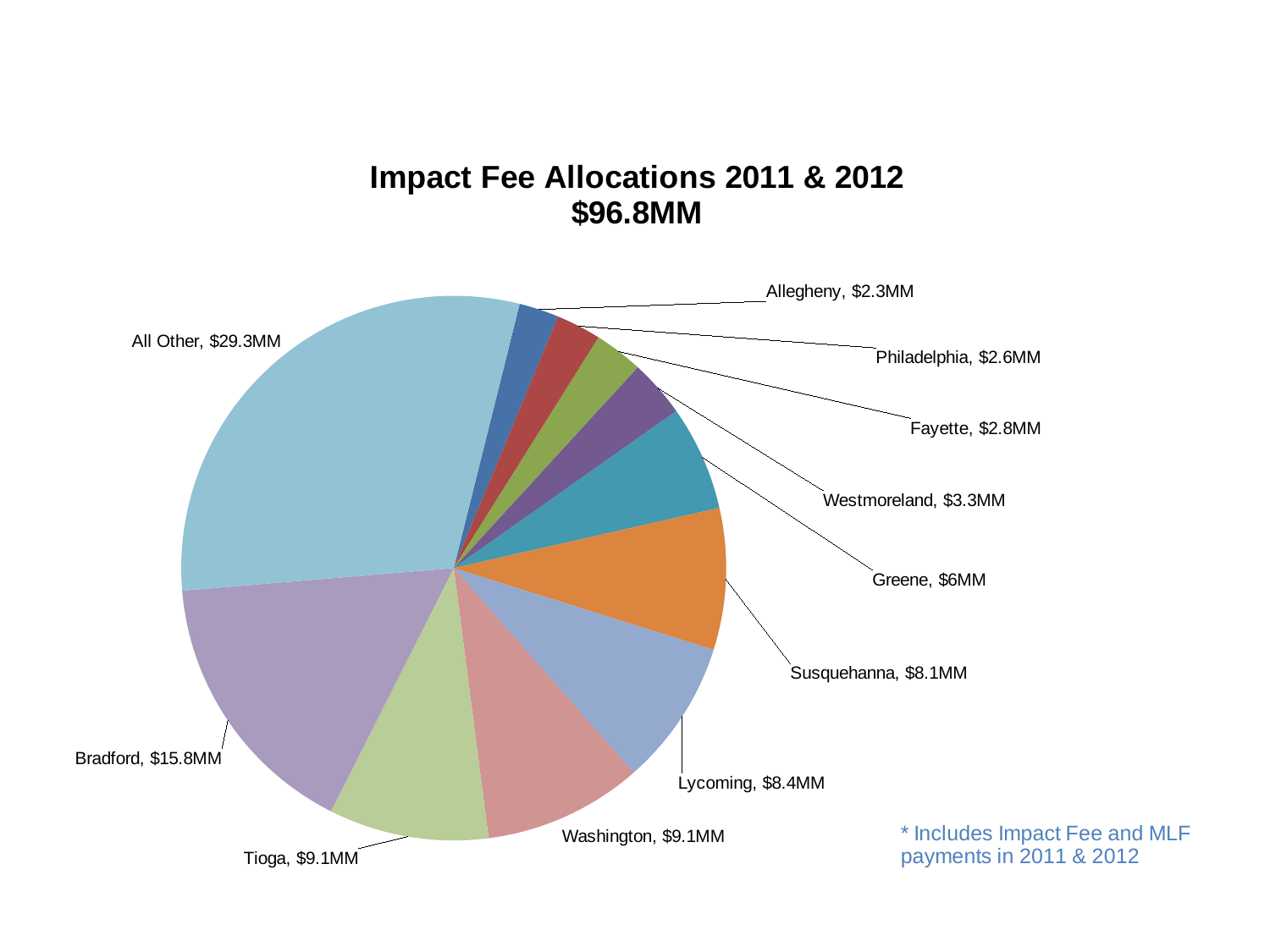
What is the difference between the values for Bradford and Tioga? $6.7MM Which slice has the largest value? All Other What is the value for Westmoreland? $3.3MM What is the title of the chart? Impact Fee Allocations 2011 & 2012 $96.8MM Which slice has the smallest value? Allegheny What is the value for Greene? $6MM Which is larger, the value for Susquehanna or the value for Greene? Susquehanna What is the value for Bradford? $15.8MM What is the value for Lycoming? $8.4MM How many slices does the pie chart have? 11 What type of chart is shown on the slide? Pie chart What is the difference between the values for Philadelphia and Allegheny? $0.3MM